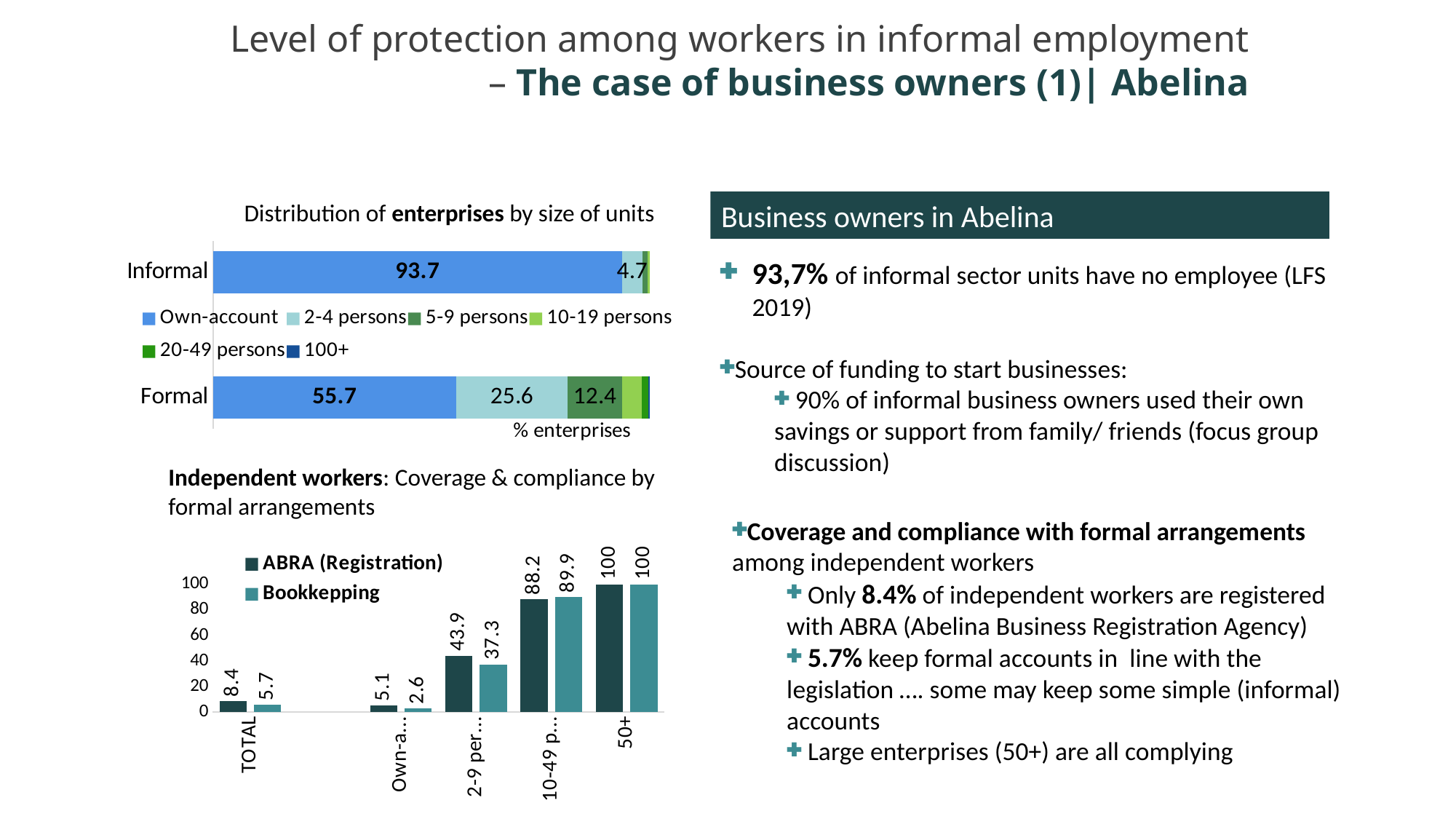
In the 'Distribution of enterprises by size of units' chart, what is the Own-account value for Informal? 93.7 In the 'Independent workers: Coverage & compliance by formal arrangements' chart, which category has the lowest ABRA (Registration) value? Own-account In the 'Distribution of enterprises by size of units' chart, which has the larger 2-4 persons value, Informal or Formal? Formal In the 'Distribution of enterprises by size of units' chart, how many series does the legend list? 6 In the 'Distribution of enterprises by size of units' chart, what is the difference between the Own-account values for Informal and Formal? 38 In the 'Distribution of enterprises by size of units' chart, what is the 5-9 persons value for Formal? 12.4 In the 'Distribution of enterprises by size of units' chart, what is the 2-4 persons value for Formal? 25.6 In the 'Independent workers: Coverage & compliance by formal arrangements' chart, how many categories are shown on the x axis? 5 What kind of chart is the 'Independent workers: Coverage & compliance by formal arrangements' chart? Bar chart In the 'Independent workers: Coverage & compliance by formal arrangements' chart, what is the difference between the ABRA (Registration) and Bookkepping values for TOTAL? 2.7 In the 'Independent workers: Coverage & compliance by formal arrangements' chart, what is the ABRA (Registration) value for TOTAL? 8.4 In the 'Independent workers: Coverage & compliance by formal arrangements' chart, what is the Bookkepping value for 50+? 100